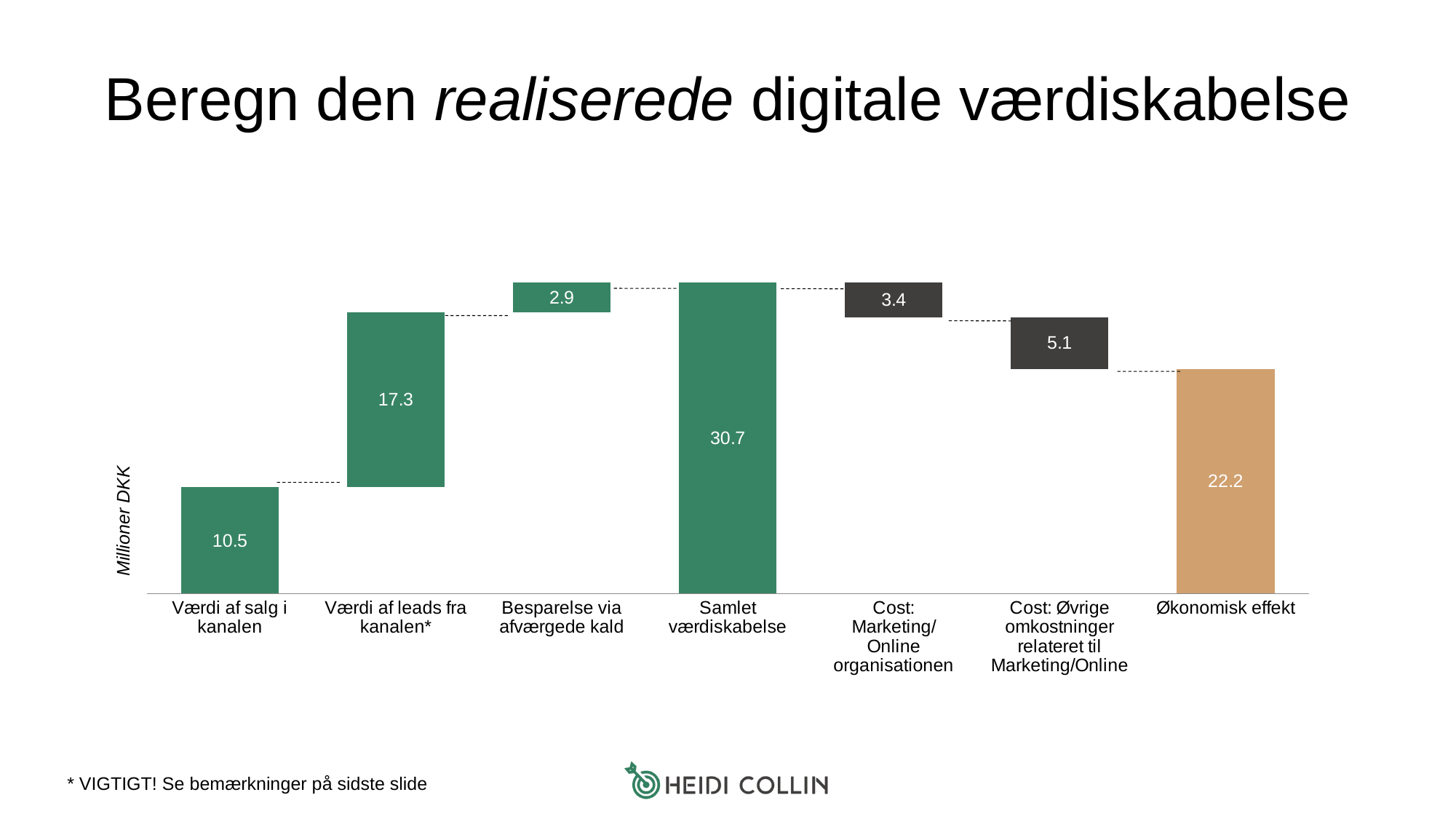
Which is larger: "Cost: Marketing/Online organisationen" or "Cost: Øvrige omkostninger relateret til Marketing/Online"? Cost: Øvrige omkostninger relateret til Marketing/Online What is the value for "Besparelse via afværgede kald"? 2.9 How many categories are shown on the x axis? 7 Which category has the highest value? Samlet værdiskabelse What is the value for "Værdi af salg i kanalen"? 10.5 What is the value for "Samlet værdiskabelse"? 30.7 What is the label on the vertical axis? Millioner DKK What is the value for "Økonomisk effekt"? 22.2 What is the difference between "Værdi af leads fra kanalen*" and "Værdi af salg i kanalen"? 6.8 What is the value for "Værdi af leads fra kanalen*"? 17.3 What kind of chart is shown on the slide? bar chart Which category has the lowest value? Besparelse via afværgede kald